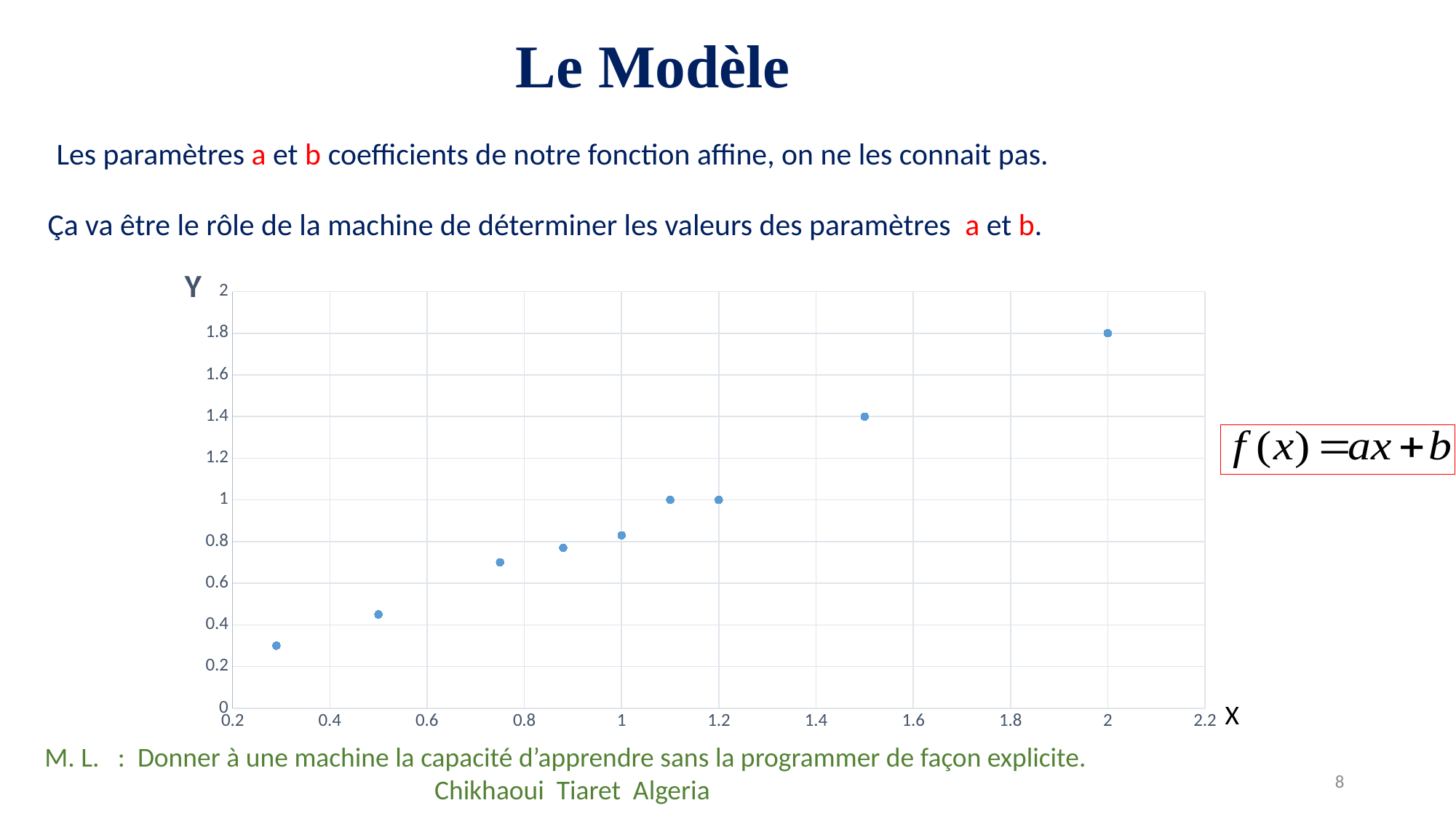
Is the Y value of the point at X = 0.5 greater or less than 0.6? less What kind of chart is shown on the slide? scatter plot What is the Y value of the point at X = 2? 1.8 Is the Y value of the leftmost point greater or less than 0.4? less How many data points are plotted on the chart? 9 Is the Y value of the point at X = 1 greater or less than 0.6? greater What is the Y value of the point at X = 1.2? 1 What formula is shown next to the chart? f(x) = ax + b Which point has the larger Y value: the one at X = 1.2 or the one at X = 2? the one at X = 2 Do the Y values generally rise or fall as X increases? rise How many points have a Y value above 1.2? 2 At which X value is the highest Y value plotted? 2